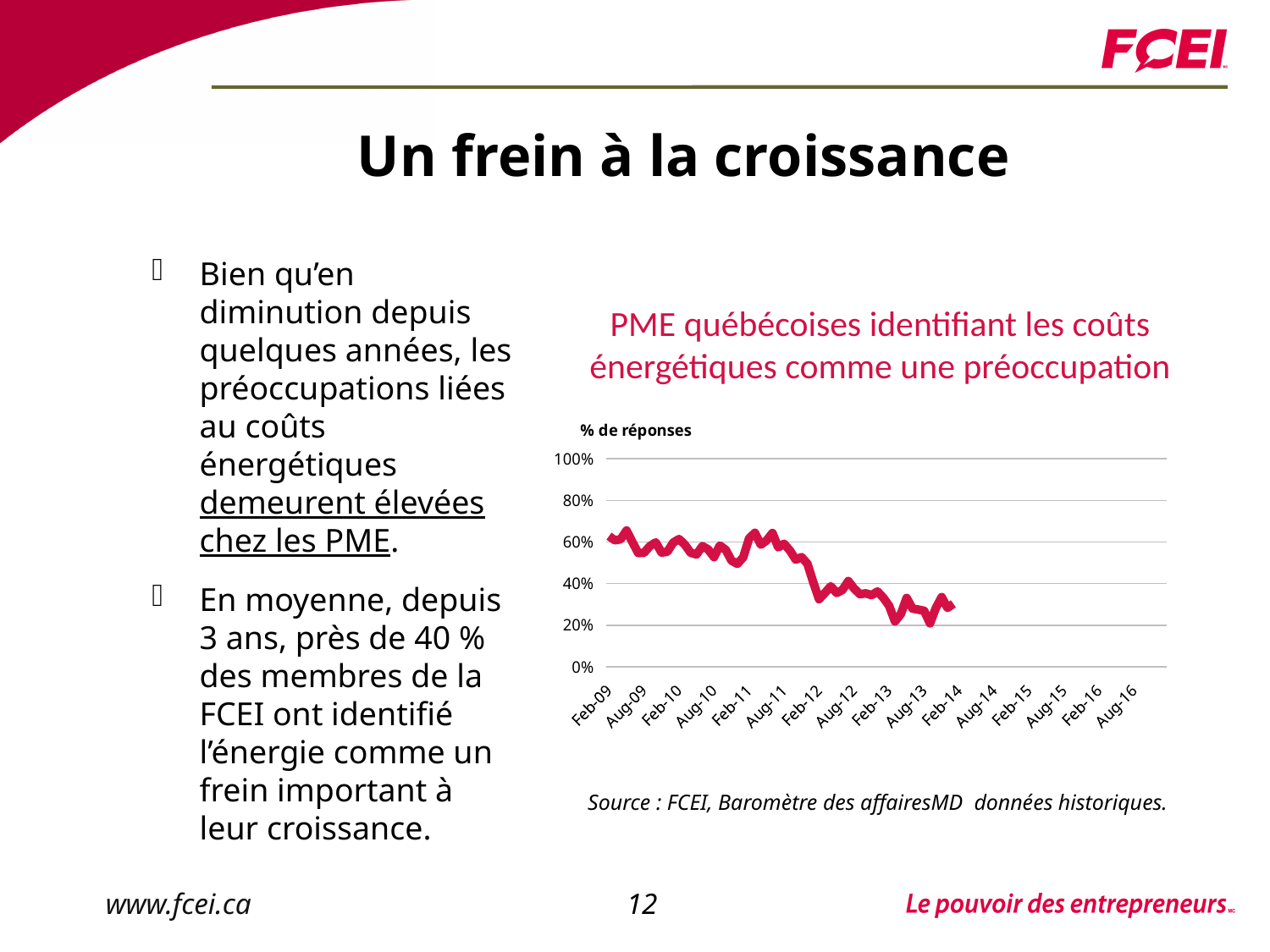
Is the value for Feb-13 greater or less than 40%? less What kind of chart is shown on the slide? line chart What is the highest value shown on the vertical axis? 100% Is the value for Feb-10 greater or less than 80%? less What is the label on the vertical axis of the chart? % de réponses What is the title of the chart? PME québécoises identifiant les coûts énergétiques comme une préoccupation How many date labels are shown on the horizontal axis? 16 Overall, do the values rise or fall from Feb-09 to Feb-14? fall Is the value for Feb-09 greater or less than the value for Feb-13? greater Is the value for Feb-09 greater or less than 40%? greater